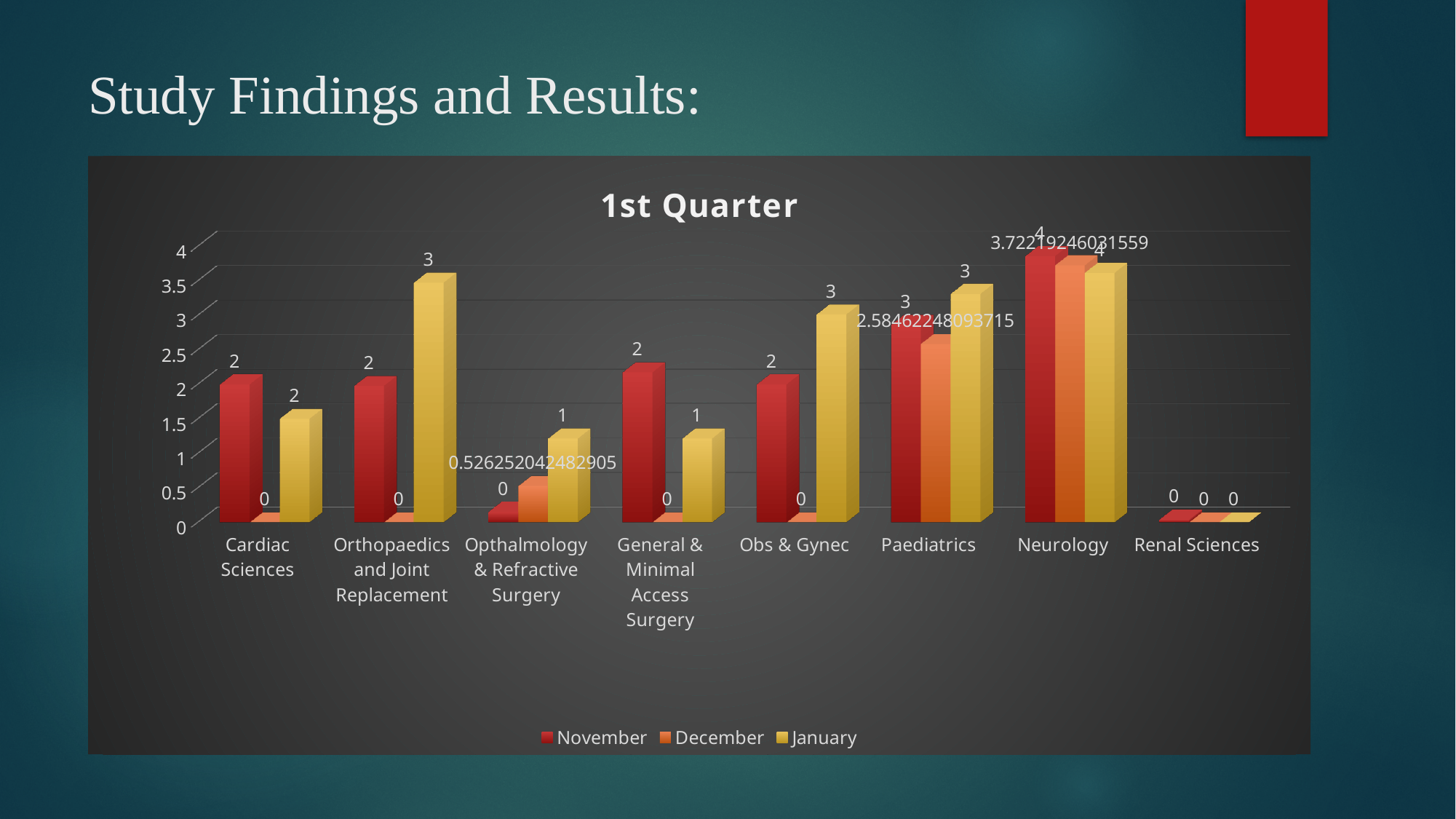
How many categories are shown on the x axis? 8 What is the December value for Opthalmology & Refractive Surgery? 0.526252042482905 Which category has the highest November value? Neurology How many series does the legend list? 3 What kind of chart is shown on the slide? bar chart What is the November value for Orthopaedics and Joint Replacement? 2 What is the January value for Obs & Gynec? 3 Which category has the lowest January value? Renal Sciences What is the difference between the January values for Orthopaedics and Joint Replacement and General & Minimal Access Surgery? 2 What is the title of the chart? 1st Quarter Which is larger, the November value for Paediatrics or the November value for Cardiac Sciences? Paediatrics What is the December value for Paediatrics? 2.58462248093715